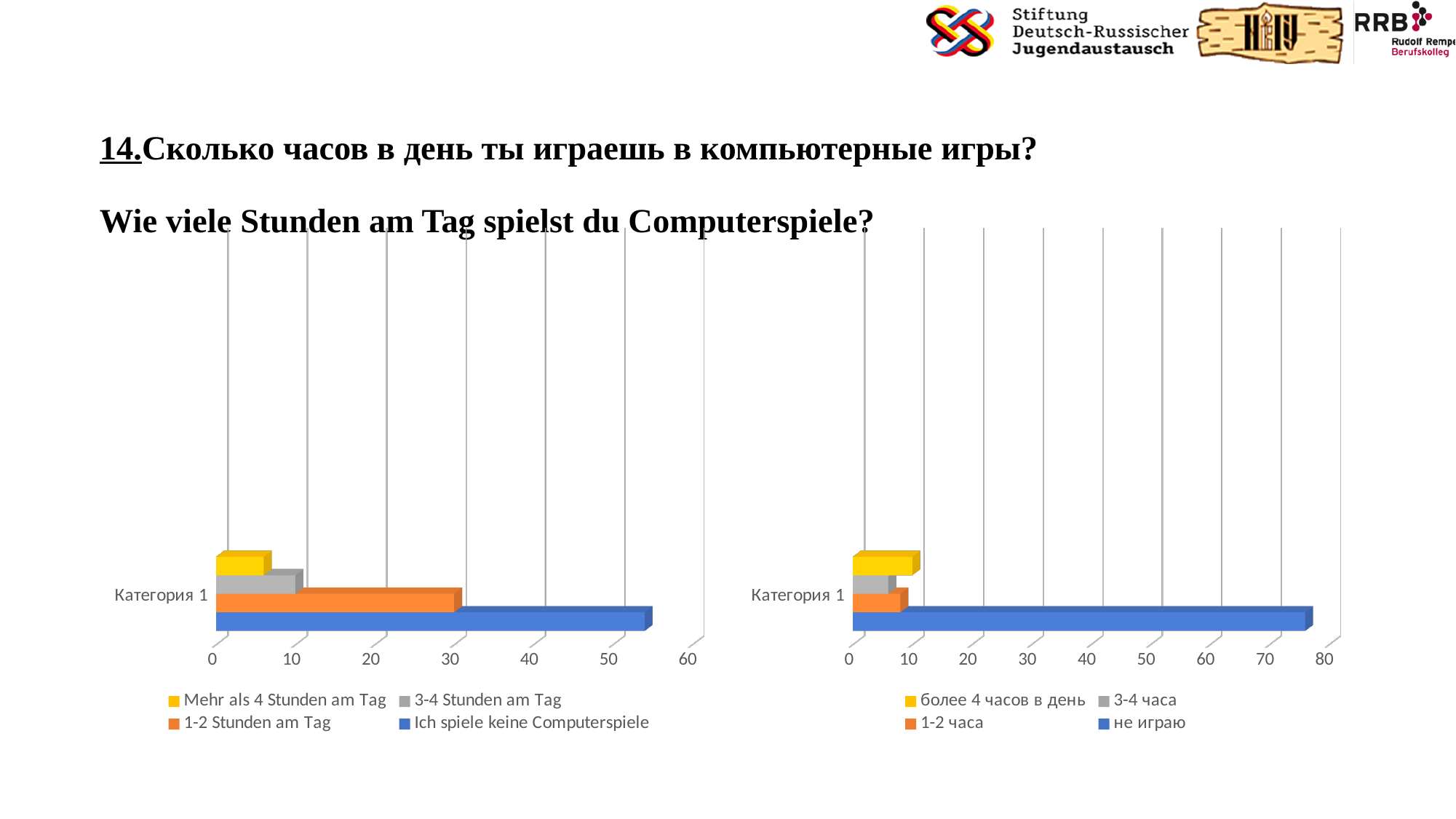
How many series does the legend of the right chart (with the Russian legend) list? 4 In the left chart, is the value for 'Ich spiele keine Computerspiele' greater or less than 40? greater What kind of chart is the left chart (with the German legend)? bar chart In the right chart, is the value for 'более 4 часов в день' greater or less than 20? less In the left chart, is the value for '1-2 Stunden am Tag' greater or less than 20? greater What is the category label shown on the vertical axis of the left chart? Категория 1 In the left chart, which is larger: '1-2 Stunden am Tag' or '3-4 Stunden am Tag'? 1-2 Stunden am Tag In the left chart, which series has the longest bar? Ich spiele keine Computerspiele How many series does the legend of the left chart list? 4 In the right chart, which series has the longest bar? не играю In the right chart, which is larger: 'не играю' or '1-2 часа'? не играю